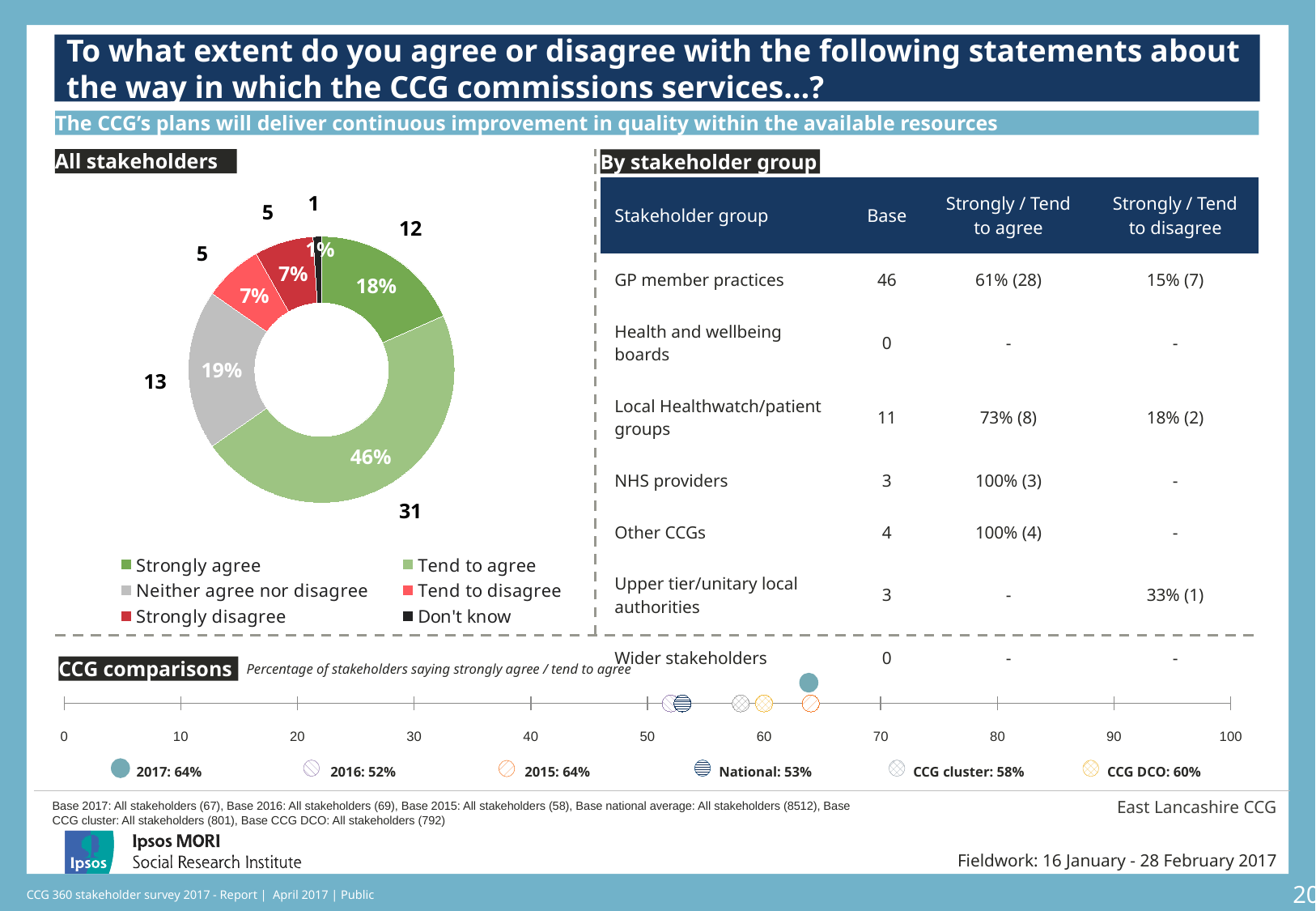
In the 'All stakeholders' chart, what percentage of stakeholders said 'Strongly agree'? 18% In the 'All stakeholders' chart, what is the difference in percentage points between 'Tend to agree' and 'Strongly agree'? 28 What type of chart is the 'All stakeholders' chart? Donut (pie) chart In the 'All stakeholders' chart, how many stakeholders said 'Neither agree nor disagree'? 13 In the 'CCG comparisons' chart, which is larger: the 2016 value or the National value? National: 53% In the 'CCG comparisons' chart, what is the 2017 percentage of stakeholders saying strongly agree / tend to agree? 64% In the 'CCG comparisons' chart, what is the difference in percentage points between the 2017 value and the 2016 value? 12 In the 'All stakeholders' chart, what percentage of stakeholders said 'Tend to agree'? 46% In the 'All stakeholders' chart, which response category has the smallest share? Don't know How many response categories does the legend of the 'All stakeholders' chart list? 6 In the 'All stakeholders' chart, what percentage said 'Neither agree nor disagree'? 19% In the 'All stakeholders' chart, which response category has the largest share? Tend to agree